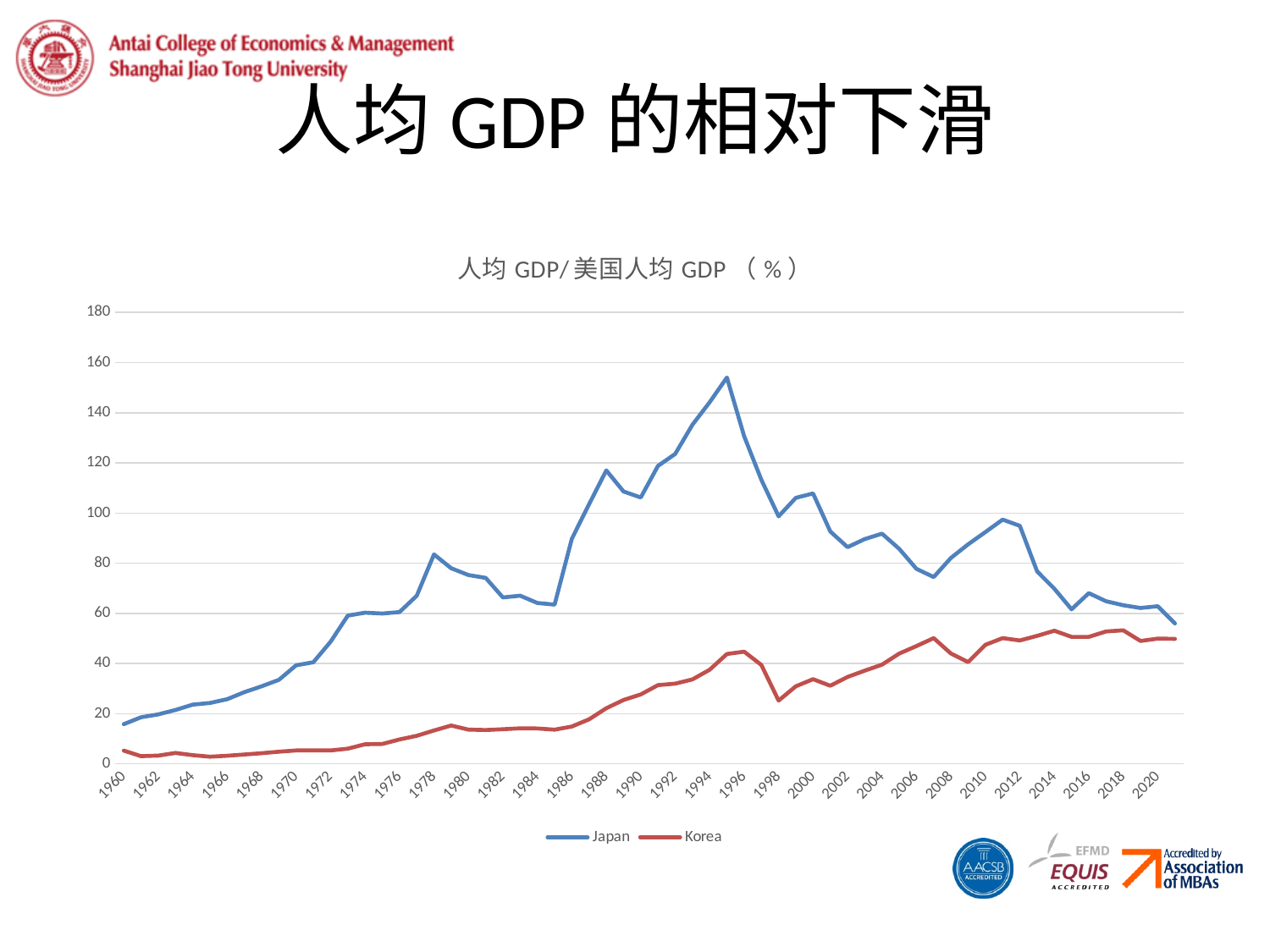
What is the title of the chart? 人均 GDP/ 美国人均 GDP （ % ） How many series does the legend list? 2 Is the value for Japan in 1995 greater or less than 140? greater Which series has the higher value in 1995, Japan or Korea? Japan What kind of chart is shown on the slide? line chart Does the Korea series generally rise or fall from 1960 to 2020? rise Is the value for Japan in 1988 greater or less than 100? greater Is the value for Korea in 1960 greater or less than 20? less What are the two series named in the legend? Japan and Korea In which year does the Japan series reach its highest value? 1995